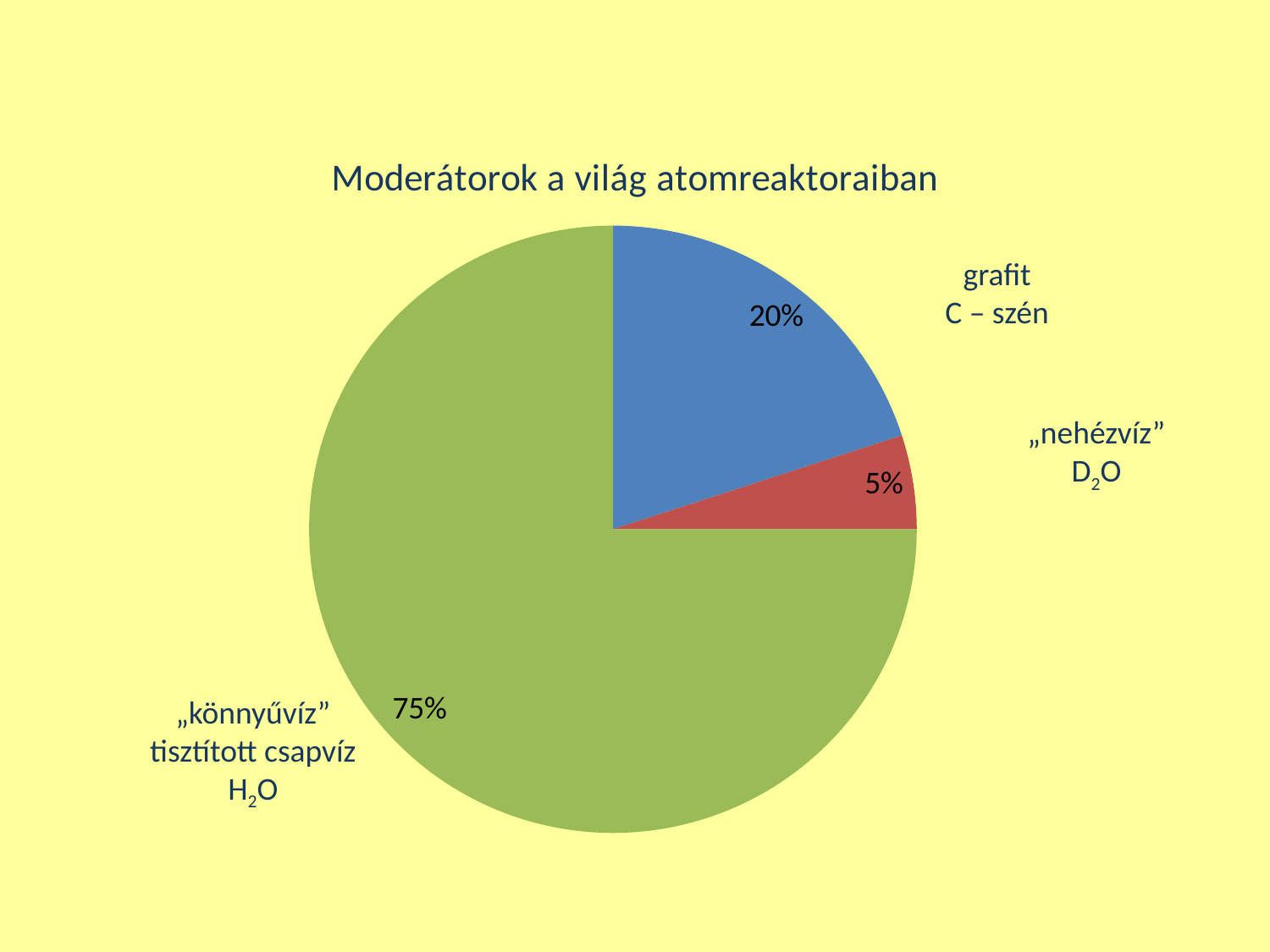
What share of the pie does the grafit (C – szén) slice represent? 20% Which is larger, the grafit slice or the "nehézvíz" slice? grafit How many slices does the pie chart have? 3 What is the difference in percentage points between the "könnyűvíz" slice and the grafit slice? 55% Which moderator has the smallest slice of the pie? "nehézvíz" (D2O) What is the title of the chart? Moderátorok a világ atomreaktoraiban Which moderator has the largest slice of the pie? "könnyűvíz" (H2O) What share of the pie does the "könnyűvíz" (H2O) slice represent? 75% What kind of chart is shown on the slide? pie chart What colour is the "könnyűvíz" slice? green What share of the pie does the "nehézvíz" (D2O) slice represent? 5% What is the difference in percentage points between the grafit slice and the "nehézvíz" slice? 15%